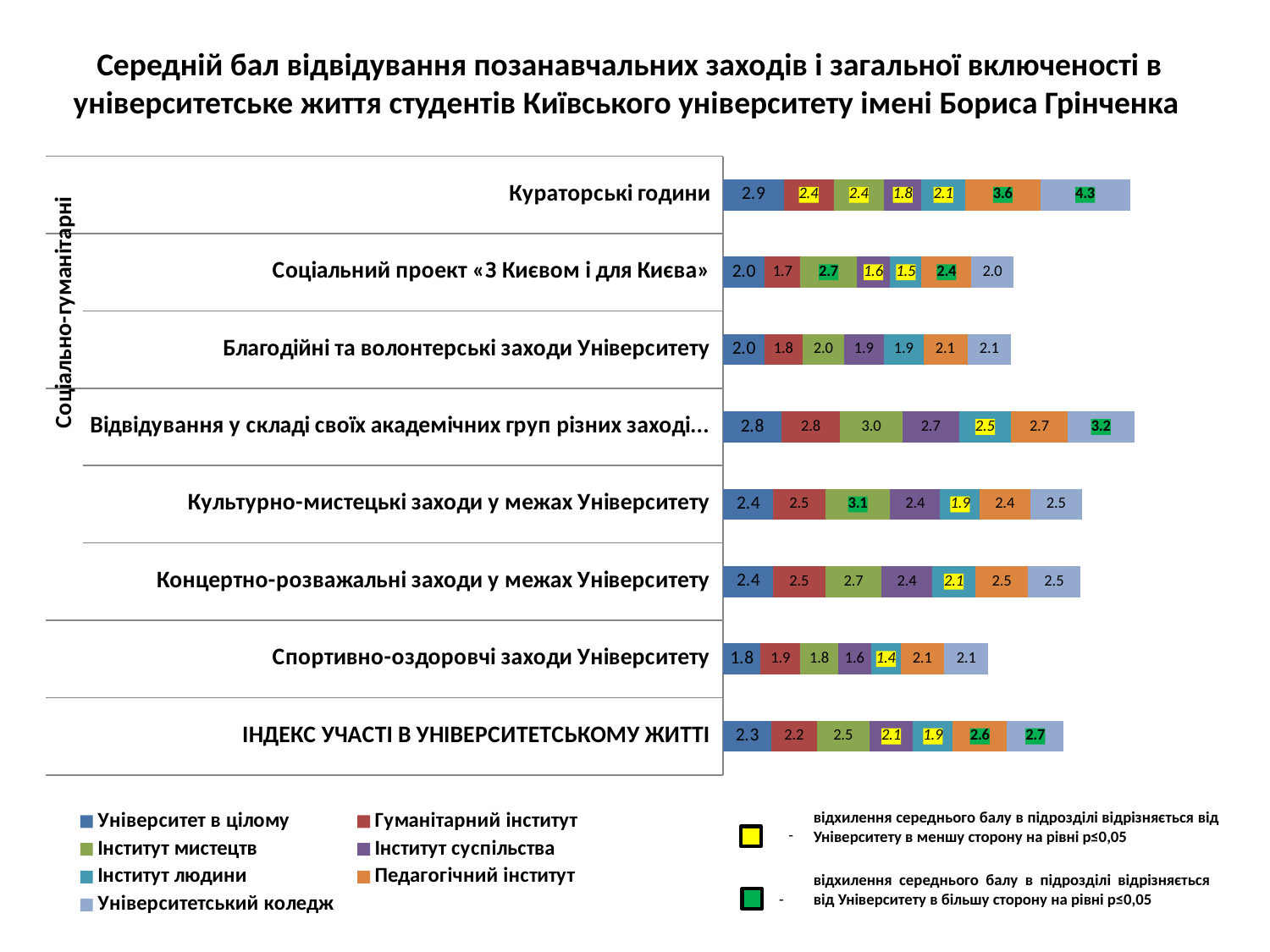
What is the value for Інститут людини in the Спортивно-оздоровчі заходи Університету bar? 1.4 How many series does the legend list? 7 What is the value for Університетський коледж in the Кураторські години bar? 4.3 In the Культурно-мистецькі заходи у межах Університету bar, which is larger: the value for Інститут мистецтв or the value for Інститут людини? Інститут мистецтв How many categories (bars) does the chart show? 8 What is the value for Університет в цілому in the ІНДЕКС УЧАСТІ В УНІВЕРСИТЕТСЬКОМУ ЖИТТІ bar? 2.3 What is the value for Інститут мистецтв in the Культурно-мистецькі заходи у межах Університету bar? 3.1 What kind of chart is shown on the slide? Stacked bar chart Which series has the lowest value in the Соціальний проект «З Києвом і для Києва» bar? Інститут людини What is the total of all segments in the Спортивно-оздоровчі заходи Університету bar? 12.7 Which series has the highest value in the Кураторські години bar? Університетський коледж In the Кураторські години bar, what is the difference between the value for Університетський коледж and the value for Університет в цілому? 1.4